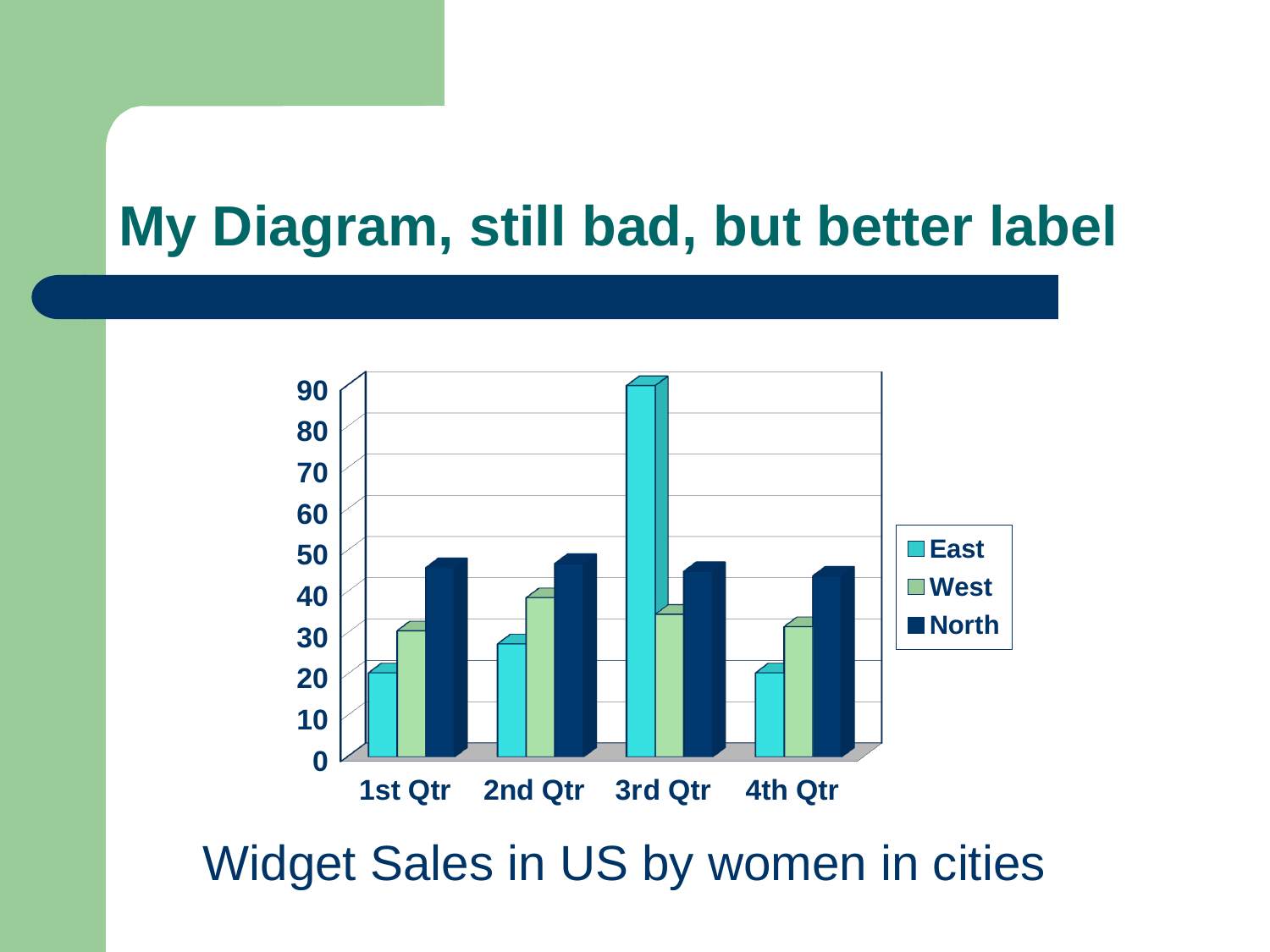
What kind of chart is shown on the slide? bar chart Is the East value for 3rd Qtr greater or less than 80? greater In 3rd Qtr, which is larger, East or North? East What caption appears below the chart? Widget Sales in US by women in cities How many quarters are shown on the x axis? 4 In 1st Qtr, which is larger, West or North? North Is the North value for 1st Qtr greater or less than 40? greater How many series does the legend list? 3 Does the East value rise or fall from 3rd Qtr to 4th Qtr? fall Is the East value for 1st Qtr greater or less than 30? less In which quarter is the East value highest? 3rd Qtr